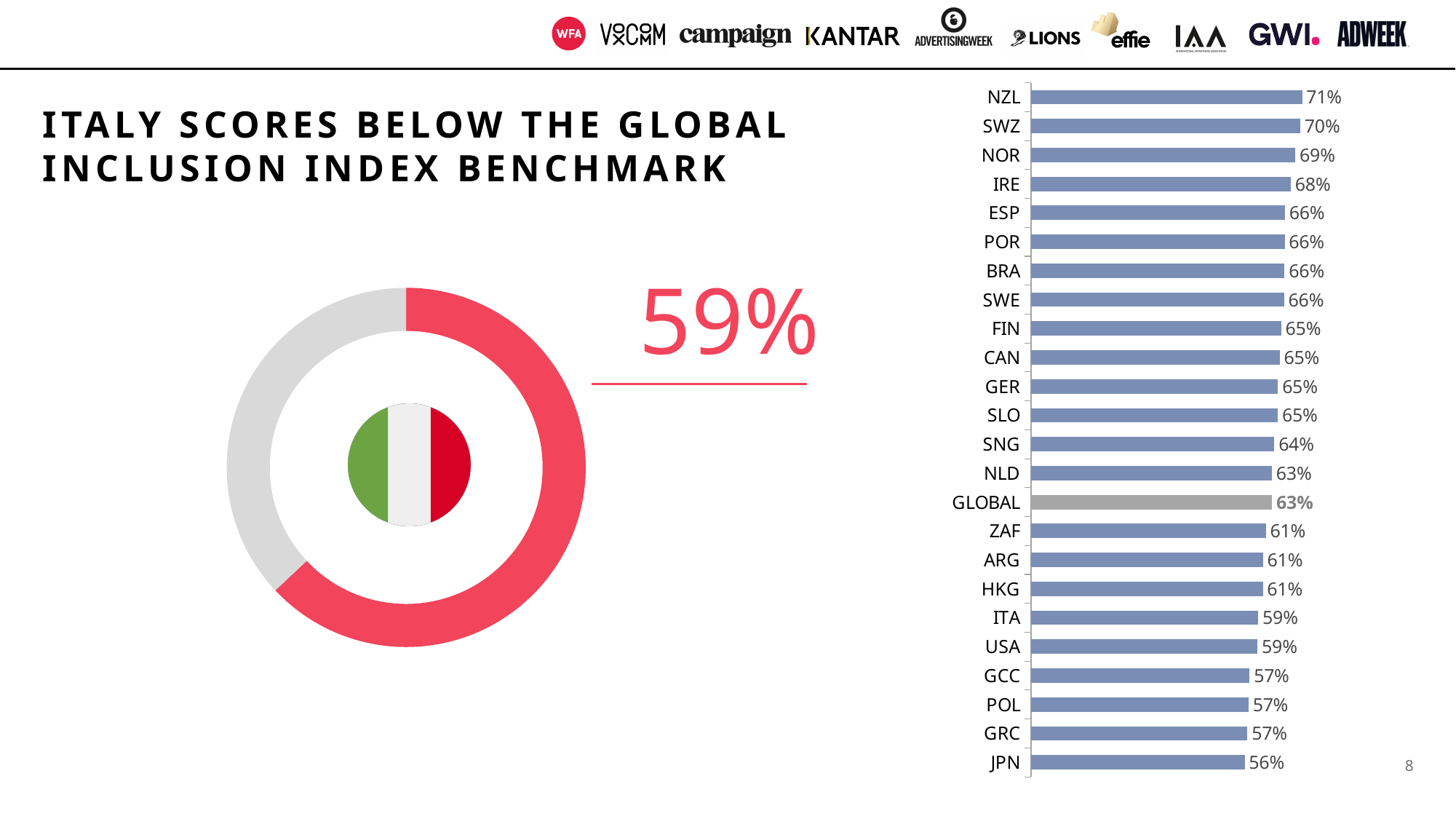
How many categories are shown in the bar chart on the right? 24 In the bar chart on the right, which category has the highest value? NZL What kind of chart is shown on the left side of the slide? donut chart In the bar chart on the right, which category has the lowest value? JPN In the bar chart on the right, what is the difference between the GLOBAL value and the ITA value? 4% What kind of chart is shown on the right side of the slide? bar chart In the bar chart on the right, what is the value for JPN? 56% In the bar chart on the right, what is the value for GLOBAL? 63% In the bar chart on the right, which is larger, the value for IRE or the value for SNG? IRE In the bar chart on the right, what is the difference between the values for NZL and JPN? 15% What value is shown next to the donut chart on the left? 59% In the bar chart on the right, what is the value for NZL? 71%